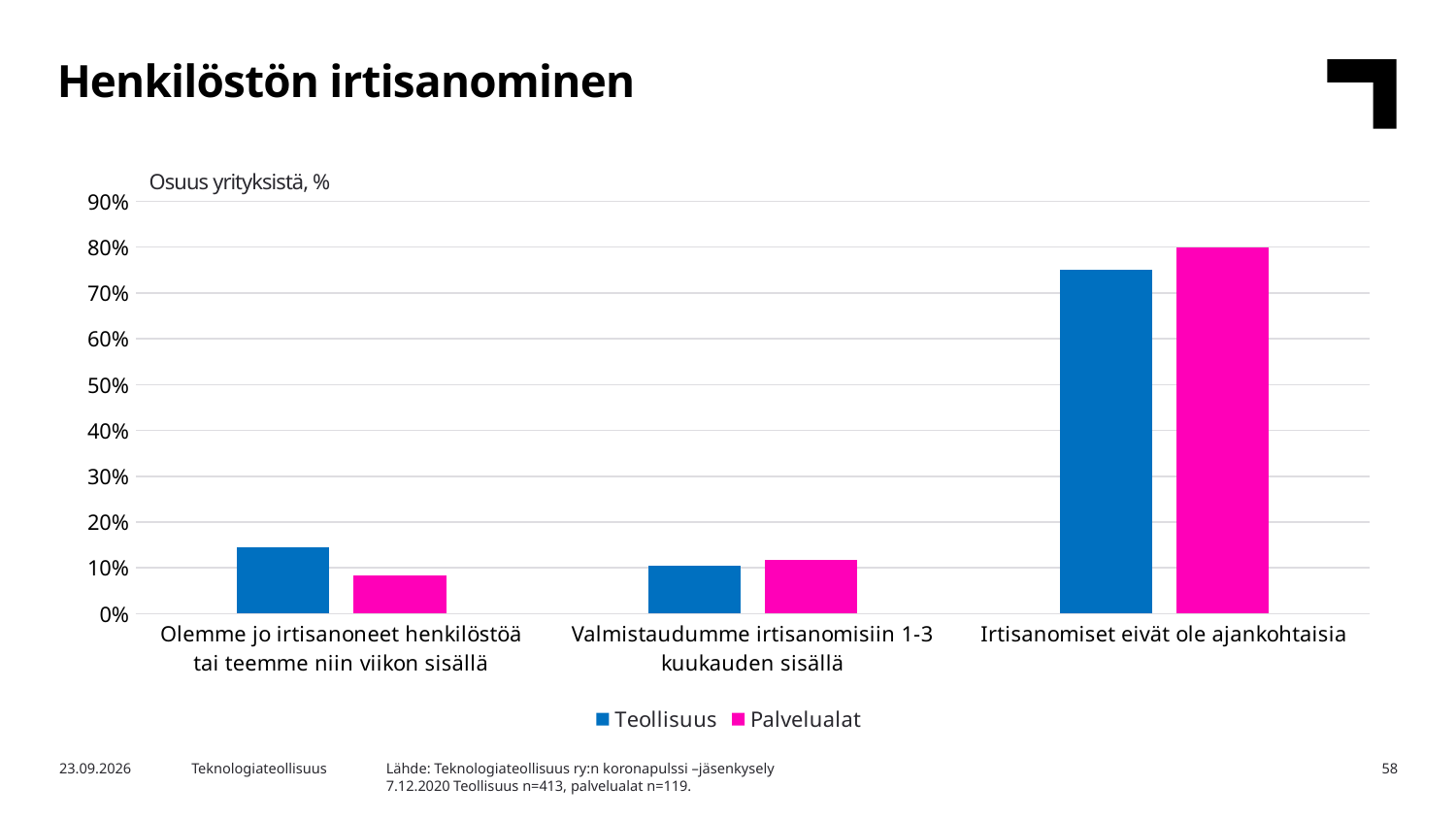
What is the title of the slide? Henkilöstön irtisanominen How many series does the legend list? 2 For the category 'Irtisanomiset eivät ole ajankohtaisia', which series has the larger value, Teollisuus or Palvelualat? Palvelualat Which category has the lowest value for Palvelualat? Olemme jo irtisanoneet henkilöstöä tai teemme niin viikon sisällä Is the Teollisuus value for 'Irtisanomiset eivät ole ajankohtaisia' greater or less than 70%? greater How many categories are shown on the x axis? 3 What kind of chart is shown on the slide? bar chart Is the Teollisuus value for 'Valmistaudumme irtisanomisiin 1-3 kuukauden sisällä' greater or less than 20%? less Which category has the highest value for Teollisuus? Irtisanomiset eivät ole ajankohtaisia Is the Palvelualat value for 'Olemme jo irtisanoneet henkilöstöä tai teemme niin viikon sisällä' greater or less than 10%? less For the category 'Olemme jo irtisanoneet henkilöstöä tai teemme niin viikon sisällä', which series has the larger value, Teollisuus or Palvelualat? Teollisuus What label is shown above the vertical axis of the chart? Osuus yrityksistä, %